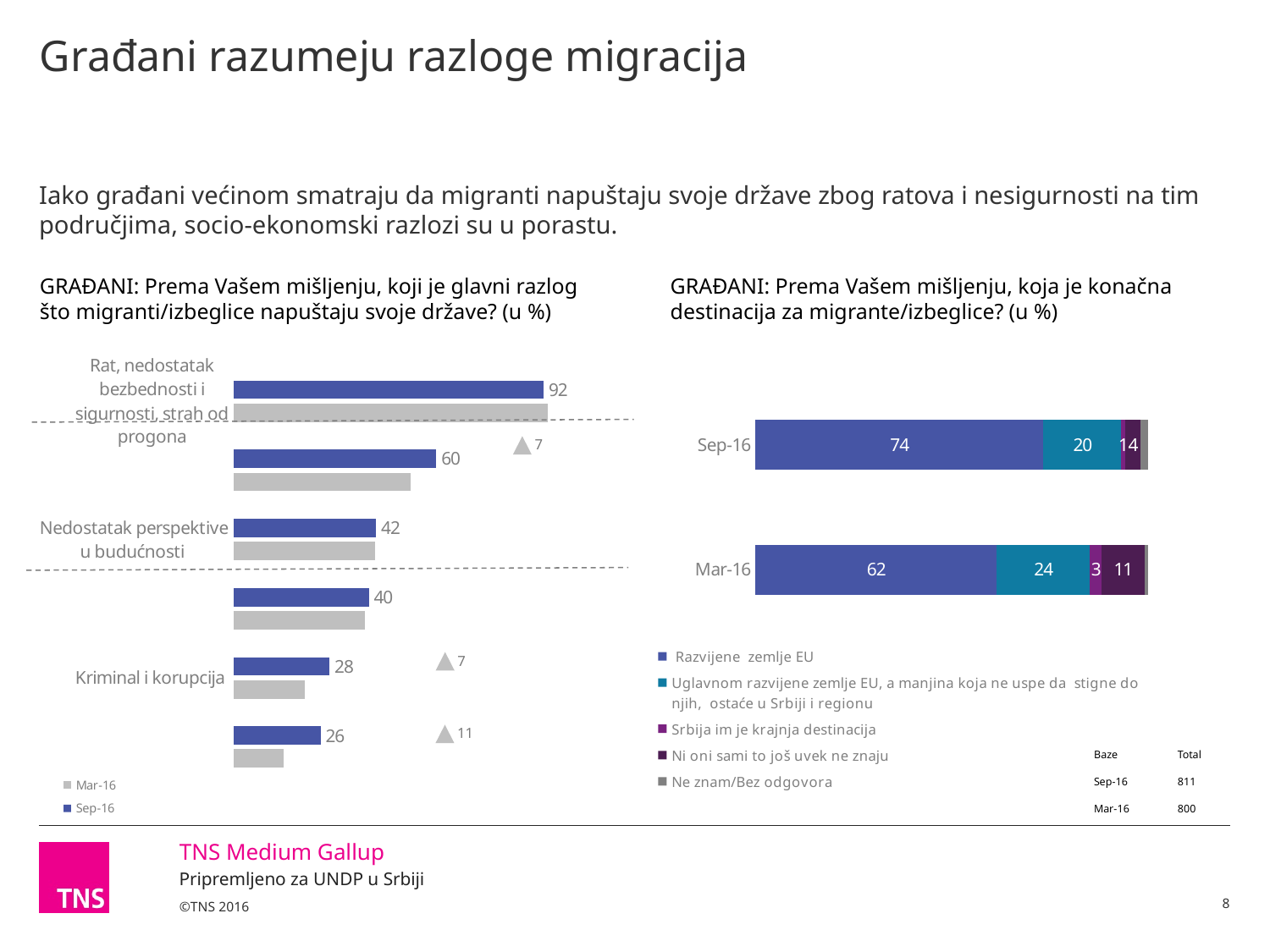
In the right chart (final destination for migrants), which period has the larger value for 'Razvijene zemlje EU', Sep-16 or Mar-16? Sep-16 In the left chart (main reason migrants leave their countries), which labelled category has the highest Sep-16 value? Rat, nedostatak bezbednosti i sigurnosti, strah od progona In the left chart (main reason migrants leave their countries), what is the difference between the Sep-16 values for 'Rat, nedostatak bezbednosti i sigurnosti, strah od progona' and 'Kriminal i korupcija'? 64 In the right chart (final destination for migrants), what is the Mar-16 value for 'Ni oni sami to još uvek ne znaju'? 11 How many series does the legend of the left chart (main reason migrants leave their countries) list? 2 What type of chart is the left chart (main reason migrants leave their countries)? Bar chart In the right chart (final destination for migrants), what is the Mar-16 value for 'Razvijene zemlje EU'? 62 In the left chart (main reason migrants leave their countries), what is the Sep-16 value for 'Rat, nedostatak bezbednosti i sigurnosti, strah od progona'? 92 In the left chart (main reason migrants leave their countries), what is the Sep-16 value for 'Kriminal i korupcija'? 28 In the left chart (main reason migrants leave their countries), what is the Sep-16 value for 'Nedostatak perspektive u budućnosti'? 42 In the right chart (final destination for migrants), what is the Sep-16 value for 'Razvijene zemlje EU'? 74 How many series does the legend of the right chart (final destination for migrants) list? 5